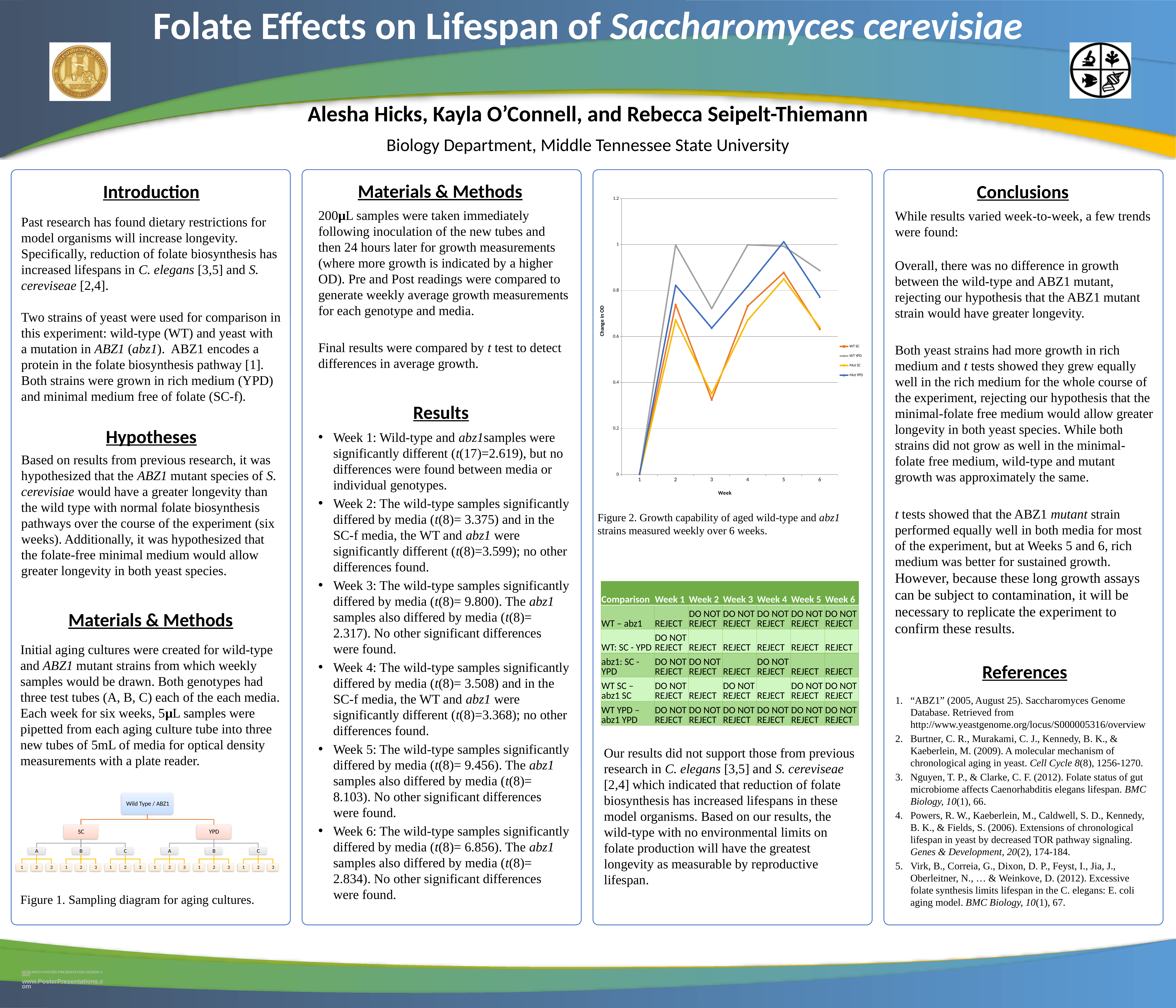
In the Figure 2 chart, which series has the highest Change in OD at Week 2? WT YPD In the Figure 2 chart, at Week 2, which is larger: WT YPD or Mut SC? WT YPD How many series does the legend of the Figure 2 chart list? 4 How many weeks are plotted along the x axis of the Figure 2 chart? 6 What kind of chart is shown in Figure 2? line chart What is the x-axis title of the Figure 2 chart? Week In the Figure 2 chart, is the WT SC value at Week 3 greater or less than 0.4? less In the Figure 2 chart, is the WT SC value at Week 5 greater or less than 0.8? greater In the Figure 2 chart, is the WT YPD value at Week 2 greater or less than 0.8? greater In the Figure 2 chart, do the values for all series rise or fall from Week 2 to Week 3? fall What is the y-axis title of the Figure 2 chart? Change in OD